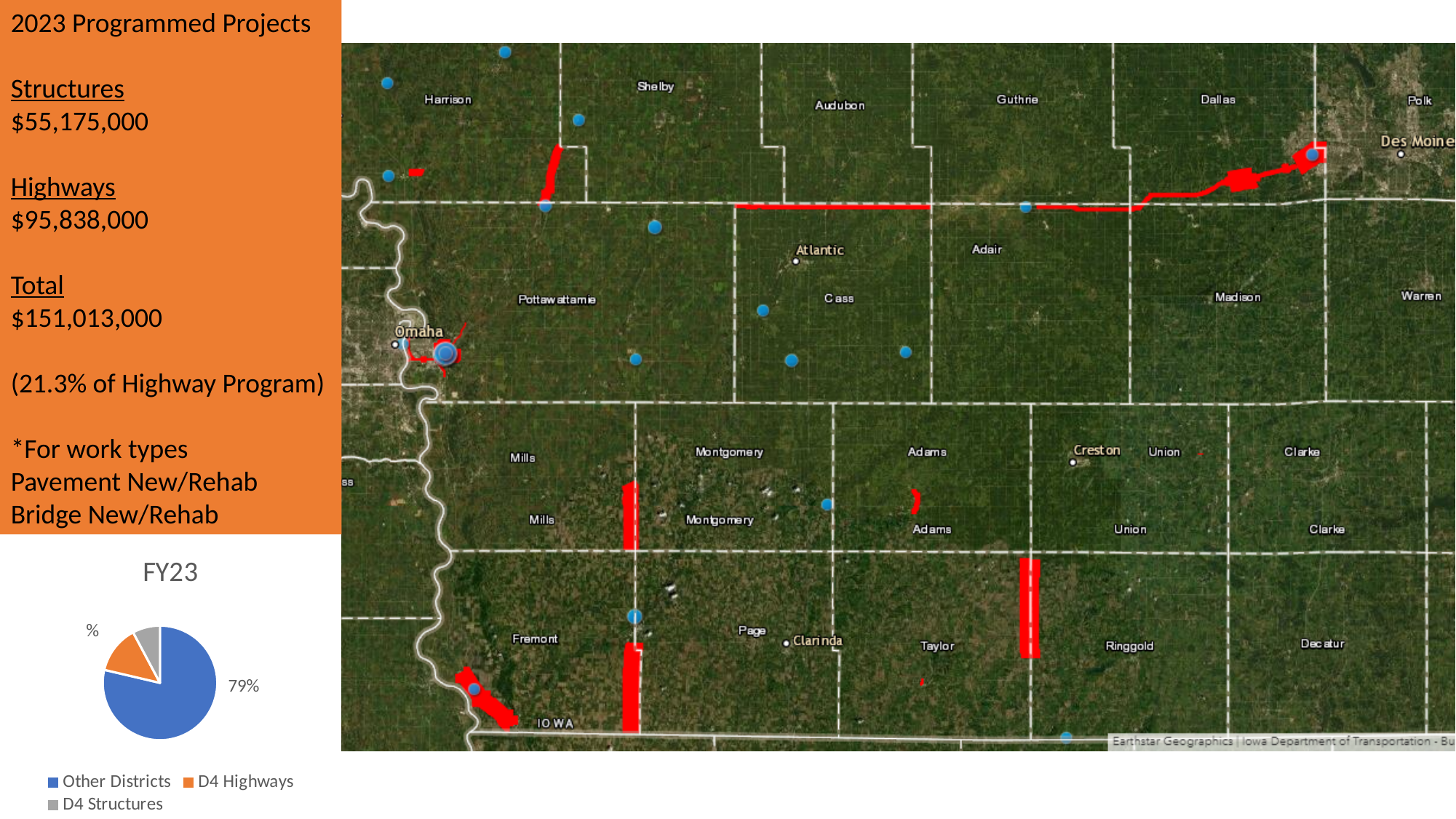
Which category has the smallest slice in the FY23 pie chart? D4 Structures In the FY23 pie chart, which is larger: D4 Highways or D4 Structures? D4 Highways Which colour represents D4 Highways in the FY23 pie chart? orange What kind of chart is the FY23 chart? pie chart How many entries does the legend of the FY23 pie chart list? 3 How many slices does the FY23 pie chart have? 3 Which category has the largest slice in the FY23 pie chart? Other Districts In the FY23 pie chart, which is larger: Other Districts or D4 Highways? Other Districts What percentage share does Other Districts have in the FY23 pie chart? 79% What is the title of the pie chart? FY23